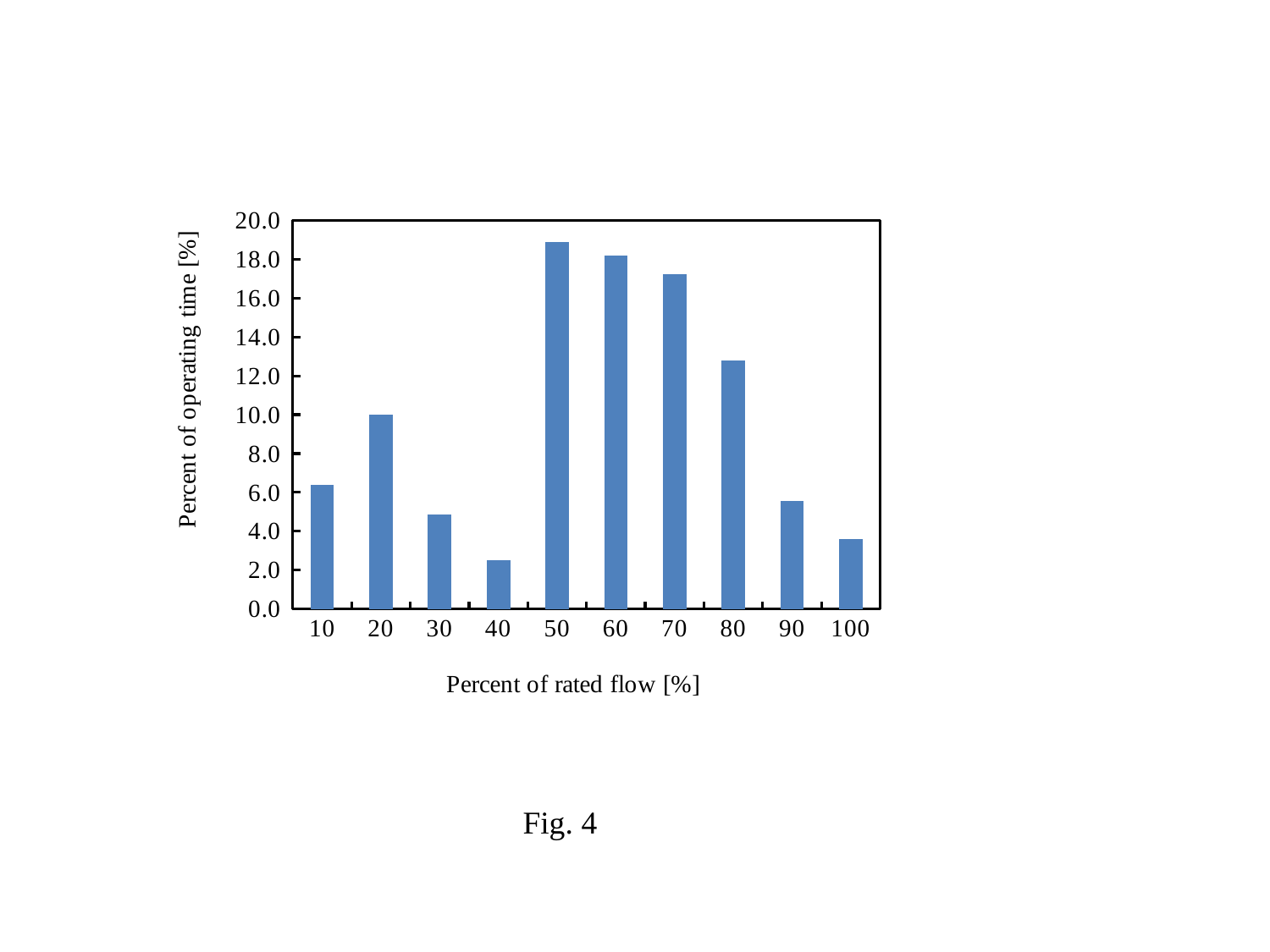
Which percent of rated flow has the lowest percent of operating time? 40 Which percent of rated flow has the highest percent of operating time? 50 Is the percent of operating time at 40% rated flow greater or less than 4.0? less Is the percent of operating time at 100% rated flow greater or less than 4.0? less Is the percent of operating time at 50% rated flow greater or less than 18.0? greater Do the values rise or fall from 50% rated flow to 100% rated flow? fall Which has a higher percent of operating time, 70% rated flow or 90% rated flow? 70 What is the label of the x axis? Percent of rated flow [%] What kind of chart is shown on the slide? bar chart How many bars (categories) are plotted on the chart? 10 Which has a higher percent of operating time, 20% rated flow or 30% rated flow? 20